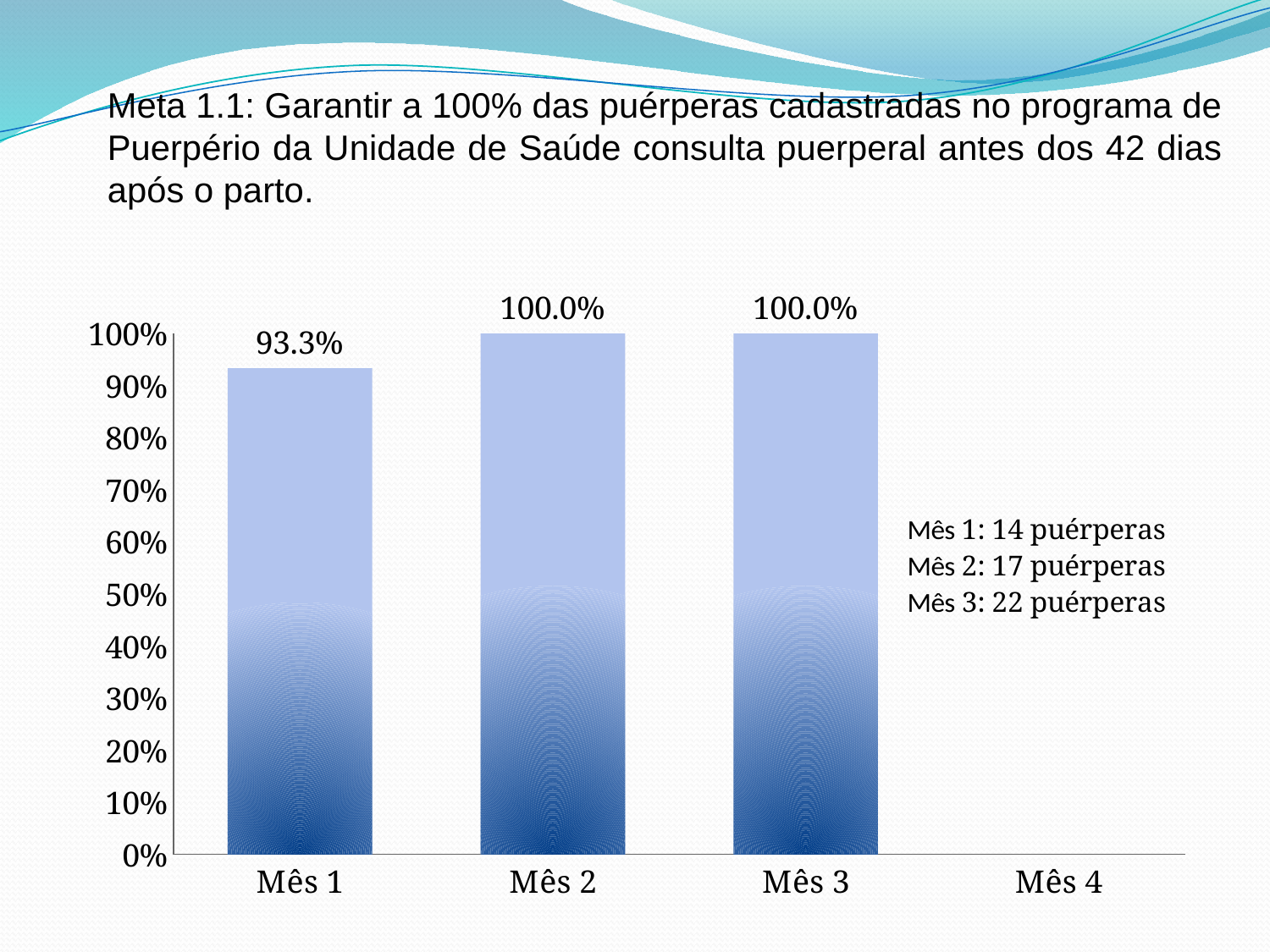
Which month has the lowest labelled value among the plotted bars? Mês 1 What is the value for Mês 1? 93.3% What is the value for Mês 3? 100.0% What kind of chart is shown on the slide? bar chart What is the value for Mês 2? 100.0% How many category labels are shown on the x axis? 4 Does the value rise or fall from Mês 1 to Mês 2? rise How many bars are plotted on the chart? 3 What is the difference between the values for Mês 2 and Mês 1? 6.7% Which is larger, the value for Mês 1 or the value for Mês 3? Mês 3 Is the value for Mês 1 greater or less than 90%? greater According to the note beside the chart, how many puérperas were there in Mês 2? 17 puérperas